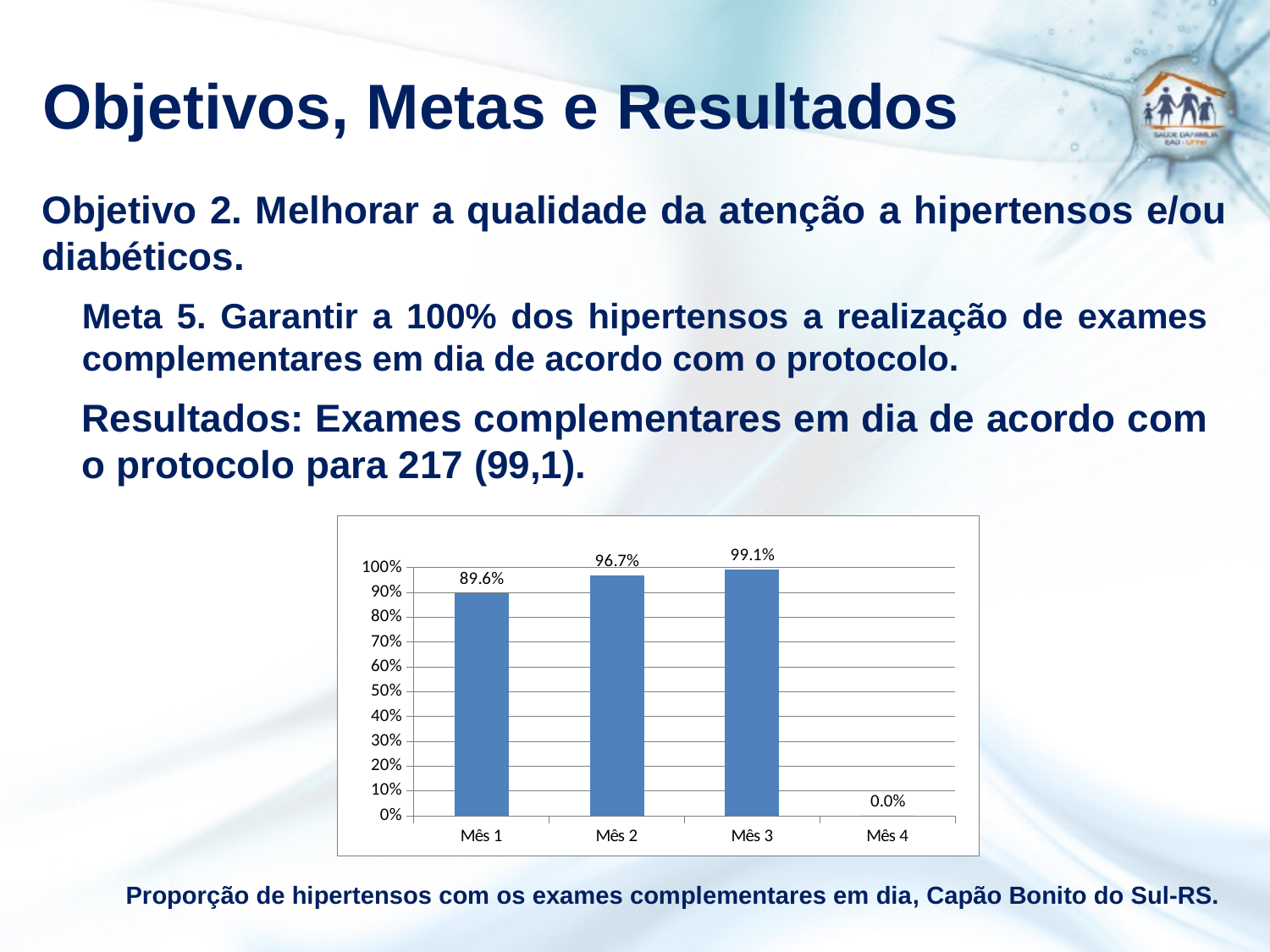
Which month has the highest value? Mês 3 How many months are shown on the x axis of the chart? 4 Which is larger, the value for Mês 2 or the value for Mês 1? Mês 2 What is the difference between the values for Mês 3 and Mês 1? 9.5% Which month has the lowest value? Mês 4 Do the values rise or fall from Mês 1 to Mês 3? rise What is the value for Mês 2? 96.7% Is the value for Mês 1 greater or less than 80%? greater What is the value for Mês 4? 0.0% What is the value for Mês 1? 89.6% What kind of chart is shown on the slide? bar chart What is the value for Mês 3? 99.1%